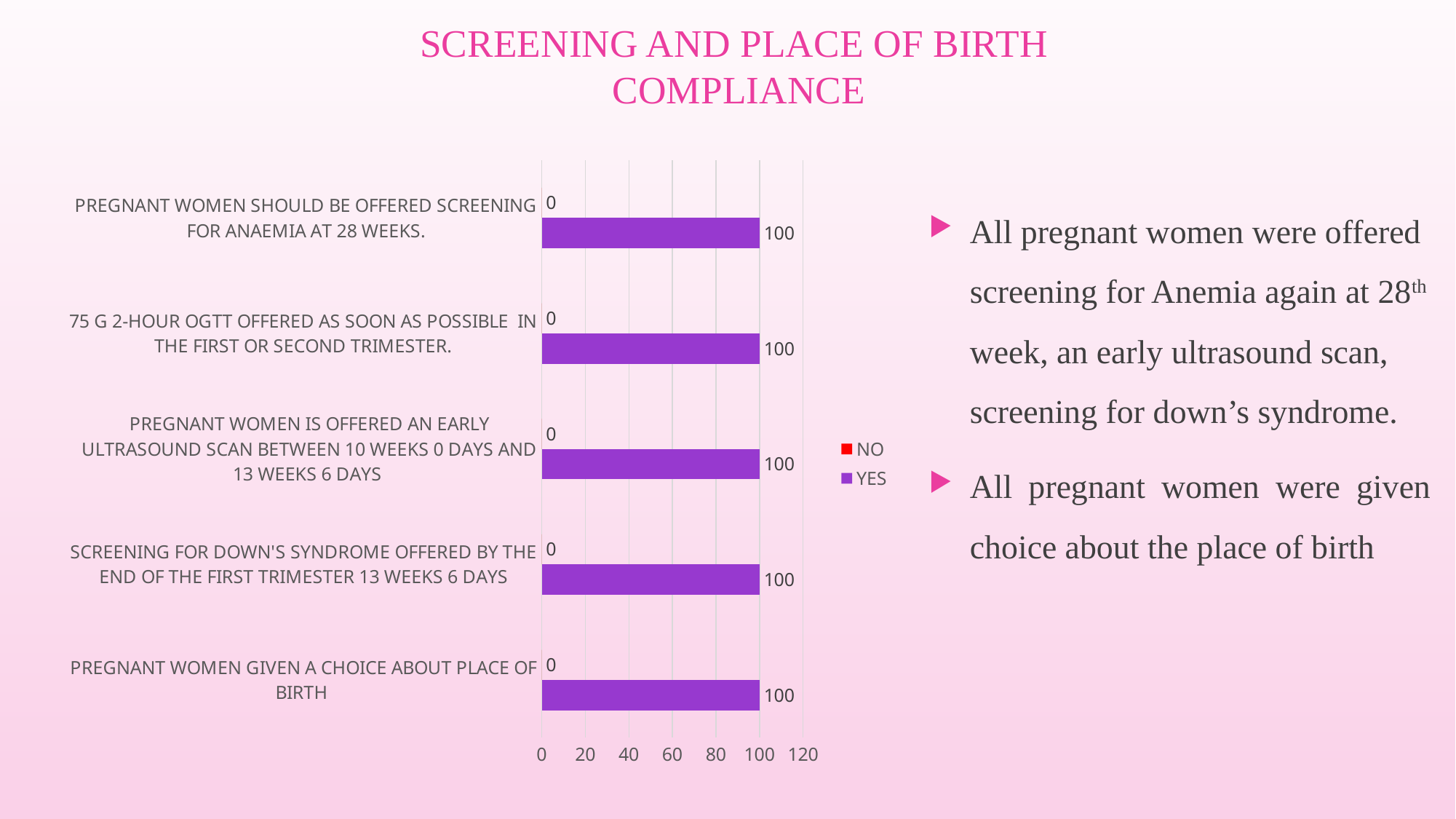
Is the YES value for "Screening for Down's syndrome offered by the end of the first trimester 13 weeks 6 days" greater or less than 80? greater How many categories are shown on the chart? 5 What is the title of the slide containing the chart? Screening and Place of Birth Compliance What kind of chart is shown on the slide? Bar chart What is the NO value for "Pregnant women should be offered screening for anaemia at 28 weeks"? 0 What colour represents the YES series in the legend? Purple Which is larger for "Pregnant women given a choice about place of birth": the YES value or the NO value? YES What is the YES value for "Pregnant women given a choice about place of birth"? 100 What is the difference between the YES and NO values for "Pregnant women is offered an early ultrasound scan between 10 weeks 0 days and 13 weeks 6 days"? 100 What is the NO value for "Screening for Down's syndrome offered by the end of the first trimester 13 weeks 6 days"? 0 How many series does the legend list? 2 What is the YES value for "75 g 2-hour OGTT offered as soon as possible in the first or second trimester"? 100